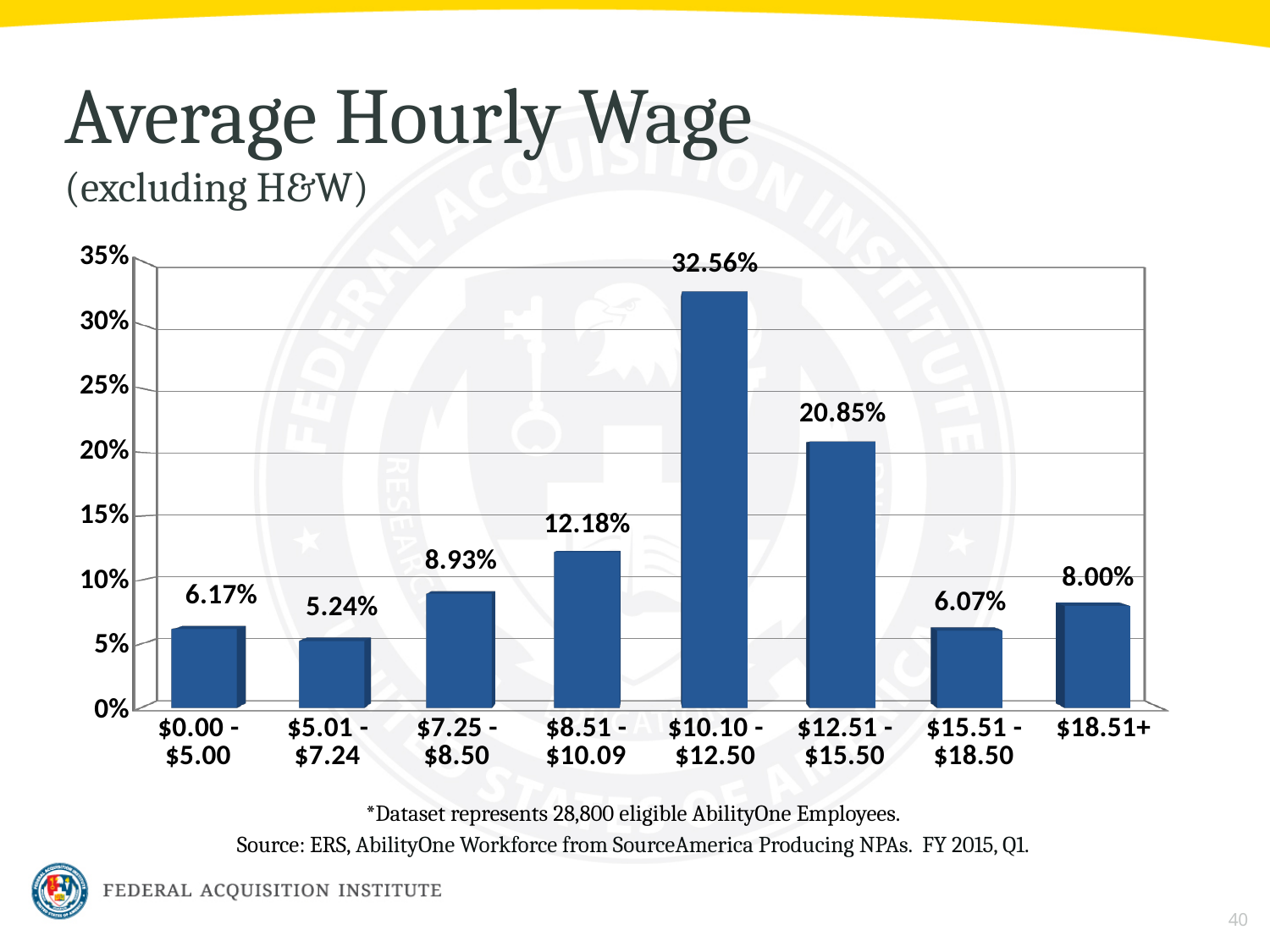
Which wage range has the lowest percentage of employees? $5.01 - $7.24 What percentage is shown for the $18.51+ wage range? 8.00% Which wage range has the highest percentage of employees? $10.10 - $12.50 Which has a larger percentage: the $7.25 - $8.50 range or the $8.51 - $10.09 range? $8.51 - $10.09 What kind of chart is shown on the slide? Bar chart What is the title of the slide containing the chart? Average Hourly Wage (excluding H&W) What is the difference between the percentages for the $10.10 - $12.50 and $12.51 - $15.50 wage ranges? 11.71% How many wage ranges are shown on the x axis? 8 Is the value for the $12.51 - $15.50 wage range greater or less than 20%? greater What is the difference between the percentages for the $0.00 - $5.00 and $15.51 - $18.50 wage ranges? 0.10% What is the value shown for the $5.01 - $7.24 wage range? 5.24% What percentage of employees earn an average hourly wage of $10.10 - $12.50? 32.56%